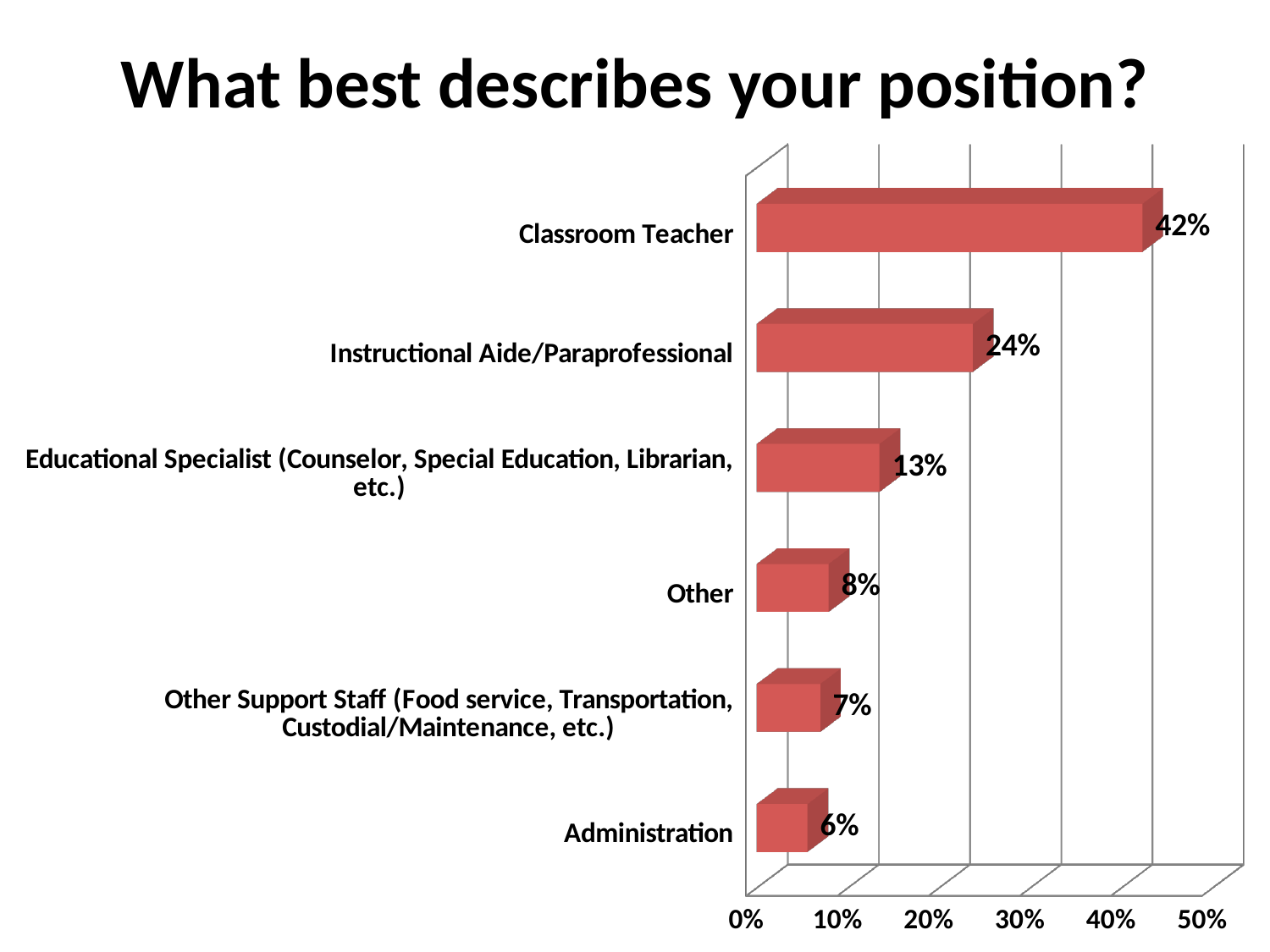
Which position has the lowest percentage? Administration Is the value for Educational Specialist (Counselor, Special Education, Librarian, etc.) greater or less than 10%? greater What percentage of respondents are Classroom Teachers? 42% What is the difference between the Classroom Teacher and Instructional Aide/Paraprofessional percentages? 18% What is the value for Other Support Staff (Food service, Transportation, Custodial/Maintenance, etc.)? 7% What is the difference between the Educational Specialist and Other percentages? 5% What is the value for Instructional Aide/Paraprofessional? 24% How many position categories are shown in the chart? 6 Which is larger, the value for Other or the value for Administration? Other What kind of chart is shown on the slide? Bar chart Which position has the highest percentage? Classroom Teacher What is the value for Administration? 6%